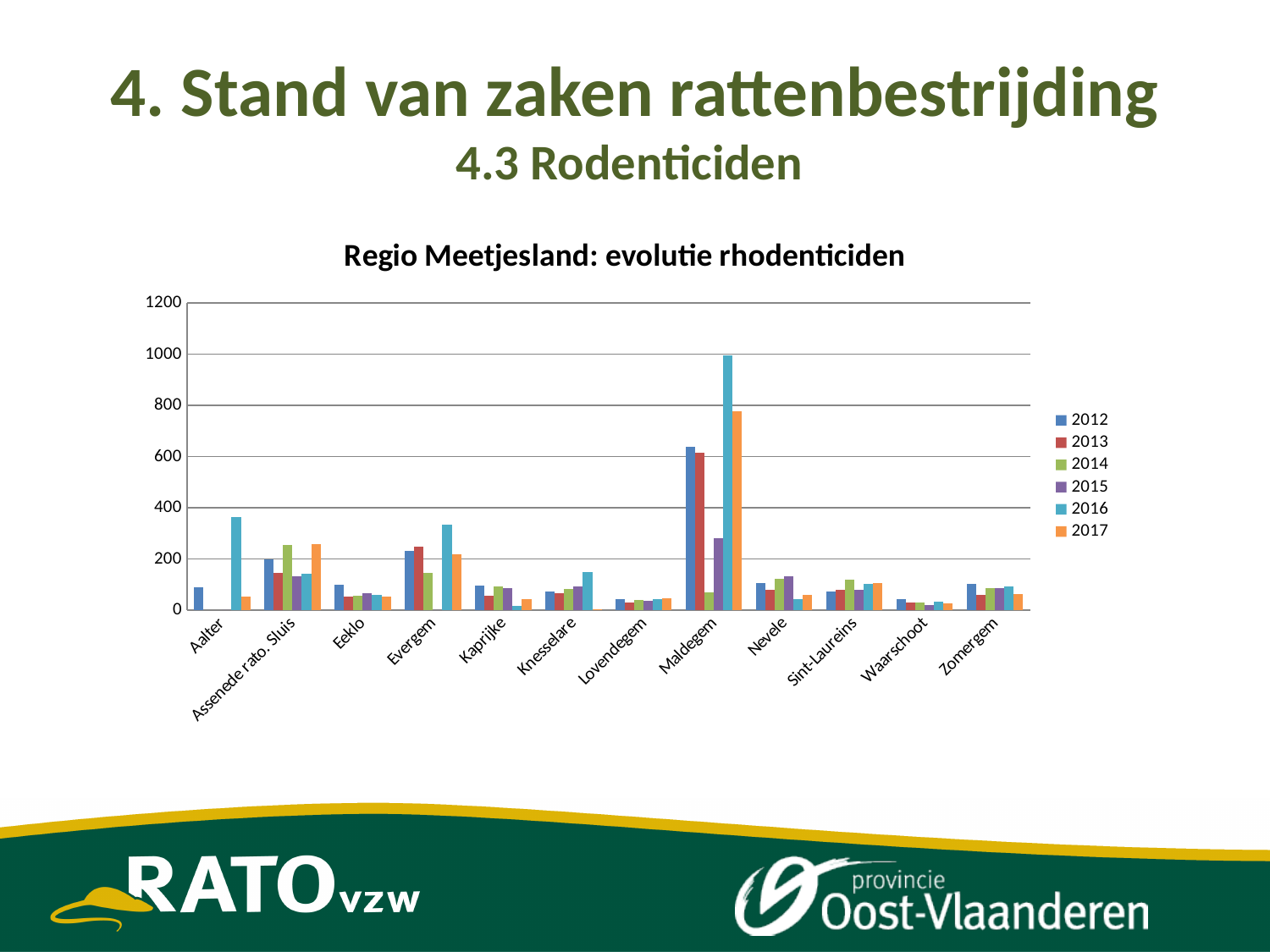
Which municipality has the highest value for 2016? Maldegem What kind of chart is shown on the slide? bar chart Is the value for Maldegem in 2015 greater or less than 400? less Is the value for Maldegem in 2017 greater or less than 600? greater For Maldegem, which year has the larger value: 2016 or 2017? 2016 Is the value for Aalter in 2016 greater or less than 200? greater For Evergem, which year has the larger value: 2013 or 2014? 2013 What is the title of the chart? Regio Meetjesland: evolutie rhodenticiden How many series does the legend list? 6 How many categories (municipalities) are shown on the x axis? 12